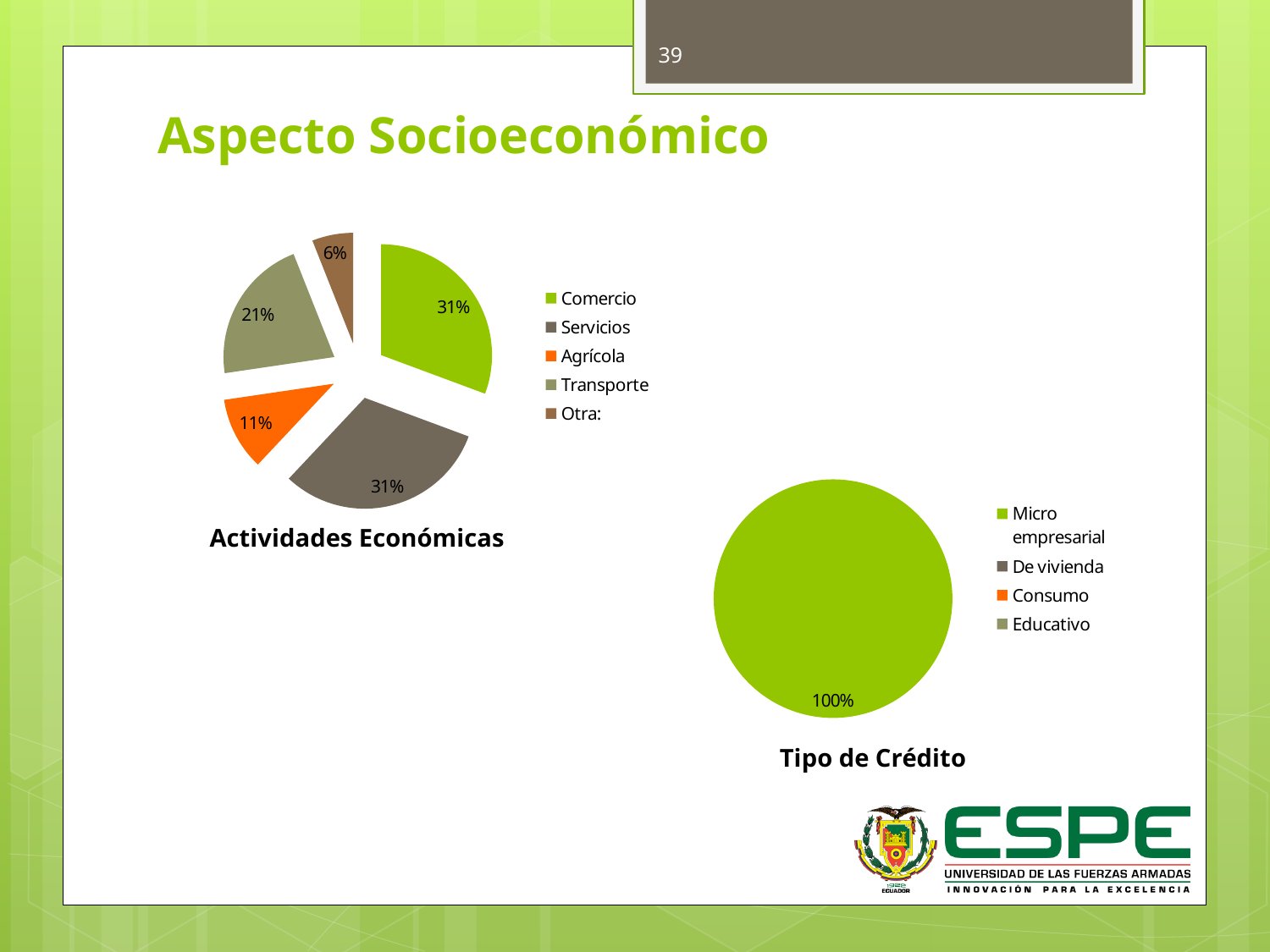
How many categories does the legend of the Tipo de Crédito chart list? 4 How many categories does the legend of the Actividades Económicas chart list? 5 In the Tipo de Crédito chart, what share does Micro empresarial have? 100% In the Actividades Económicas chart, what is the difference between the shares of Transporte and Otra:? 15% In the Actividades Económicas chart, what share does Agrícola have? 11% In the Actividades Económicas chart, which category has the smallest share? Otra: In the Actividades Económicas chart, what share does Transporte have? 21% In the Actividades Económicas chart, what share does Comercio have? 31% In the Actividades Económicas chart, what colour is the Agrícola slice? Orange What kind of chart is the Actividades Económicas chart? Pie chart In the Actividades Económicas chart, what share does Otra: have? 6% In the Actividades Económicas chart, which is larger, Transporte or Agrícola? Transporte